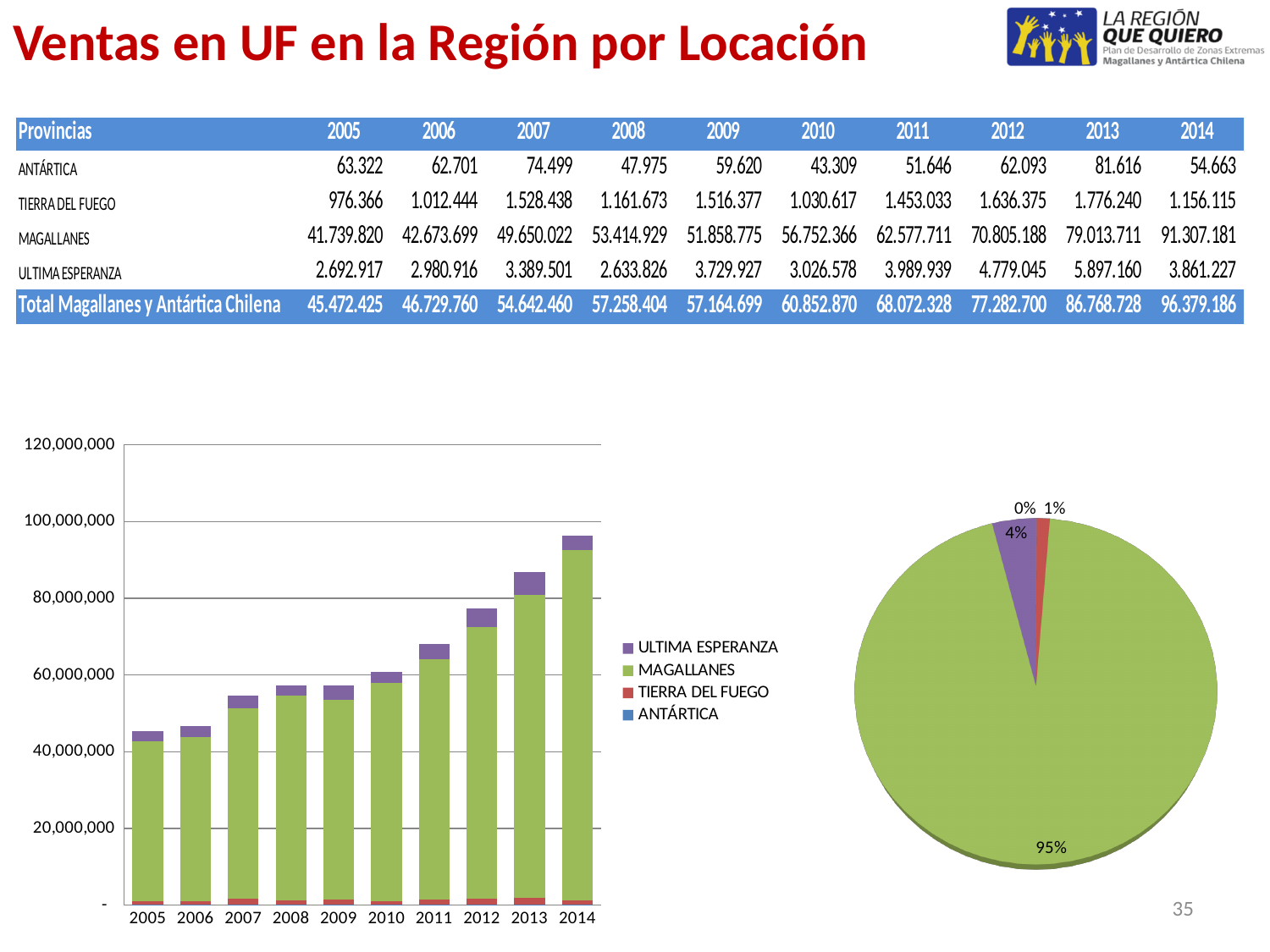
In the pie chart, what share does MAGALLANES have? 95% How many years are shown on the x axis of the bar chart? 10 In the bar chart, do the stacked bar totals generally rise or fall from 2005 to 2014? rise What kind of chart is shown on the left side of the slide? bar chart In the pie chart, what share does ULTIMA ESPERANZA have? 4% In the bar chart, is the stacked bar for 2013 taller or shorter than the bar for 2012? taller How many series does the legend of the bar chart list? 4 In the bar chart, is the total stacked bar for 2005 greater or less than 60,000,000? less In the bar chart, is the total stacked bar for 2014 greater or less than 80,000,000? greater In the bar chart, which year has the tallest stacked bar? 2014 In the bar chart, which year has the shortest stacked bar? 2005 What kind of chart is shown on the right side of the slide? pie chart